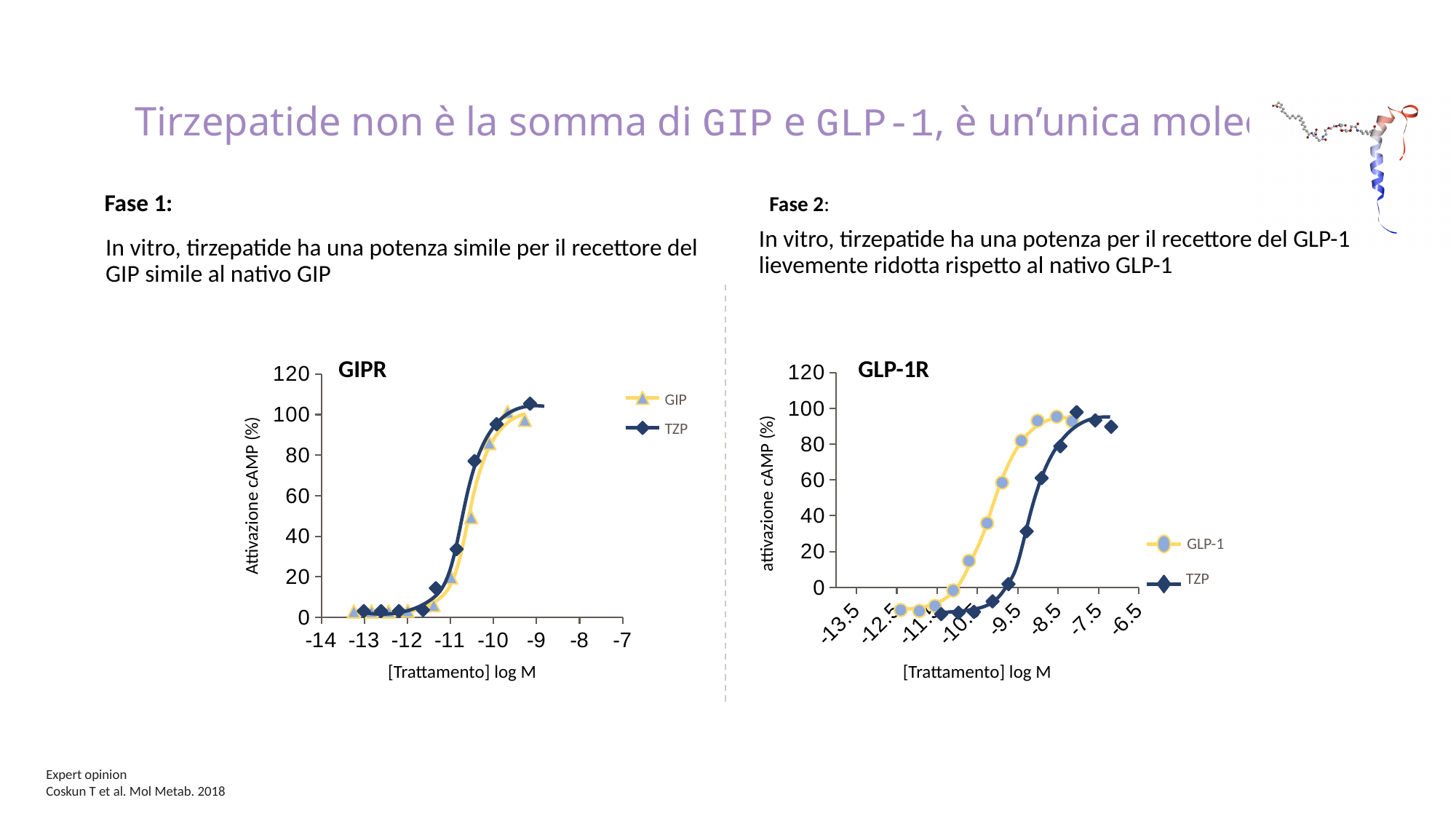
In the GLP-1R chart, do the GLP-1 values rise or fall as the x axis goes from -11.5 to -8.5? rise What kind of chart is the GIPR chart on the left? line chart In the GLP-1R chart, is the GLP-1 value at -8.5 greater or less than 80? greater How many series does the legend of the GIPR chart list? 2 In the GLP-1R chart, is the TZP value at -7.5 greater or less than 80? greater In the GIPR chart, is the TZP value at -9 greater or less than 100? greater In the GIPR chart, do the TZP values rise or fall as the x axis goes from -13 to -9? rise What is the label of the x axis on the GIPR chart? [Trattamento] log M In the GLP-1R chart, at -9.5 which series has the higher value, GLP-1 or TZP? GLP-1 Which two series are shown in the legend of the GLP-1R chart? GLP-1 and TZP